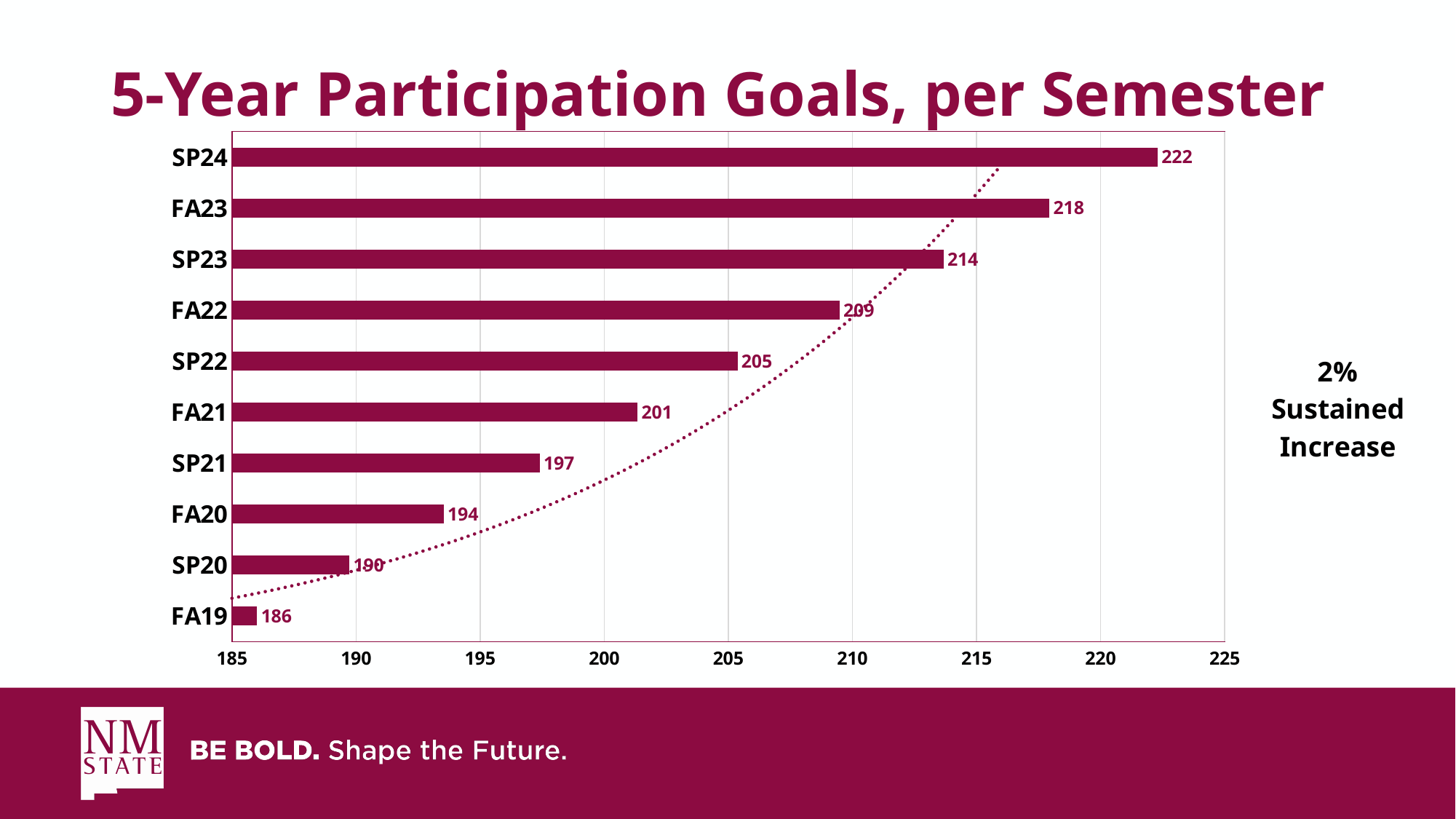
Which semester has the lowest participation goal? FA19 What is the participation goal for SP22? 205 What is the difference between the participation goals for FA23 and SP23? 4 Which has a larger participation goal, SP21 or FA20? SP21 How many semesters are shown in the chart? 10 What is the participation goal for FA19? 186 What is the participation goal for FA21? 201 Which semester has the highest participation goal? SP24 What is the title of the chart? 5-Year Participation Goals, per Semester What is the difference between the participation goals for SP24 and FA19? 36 What kind of chart is shown on the slide? Bar chart What is the participation goal for SP24? 222